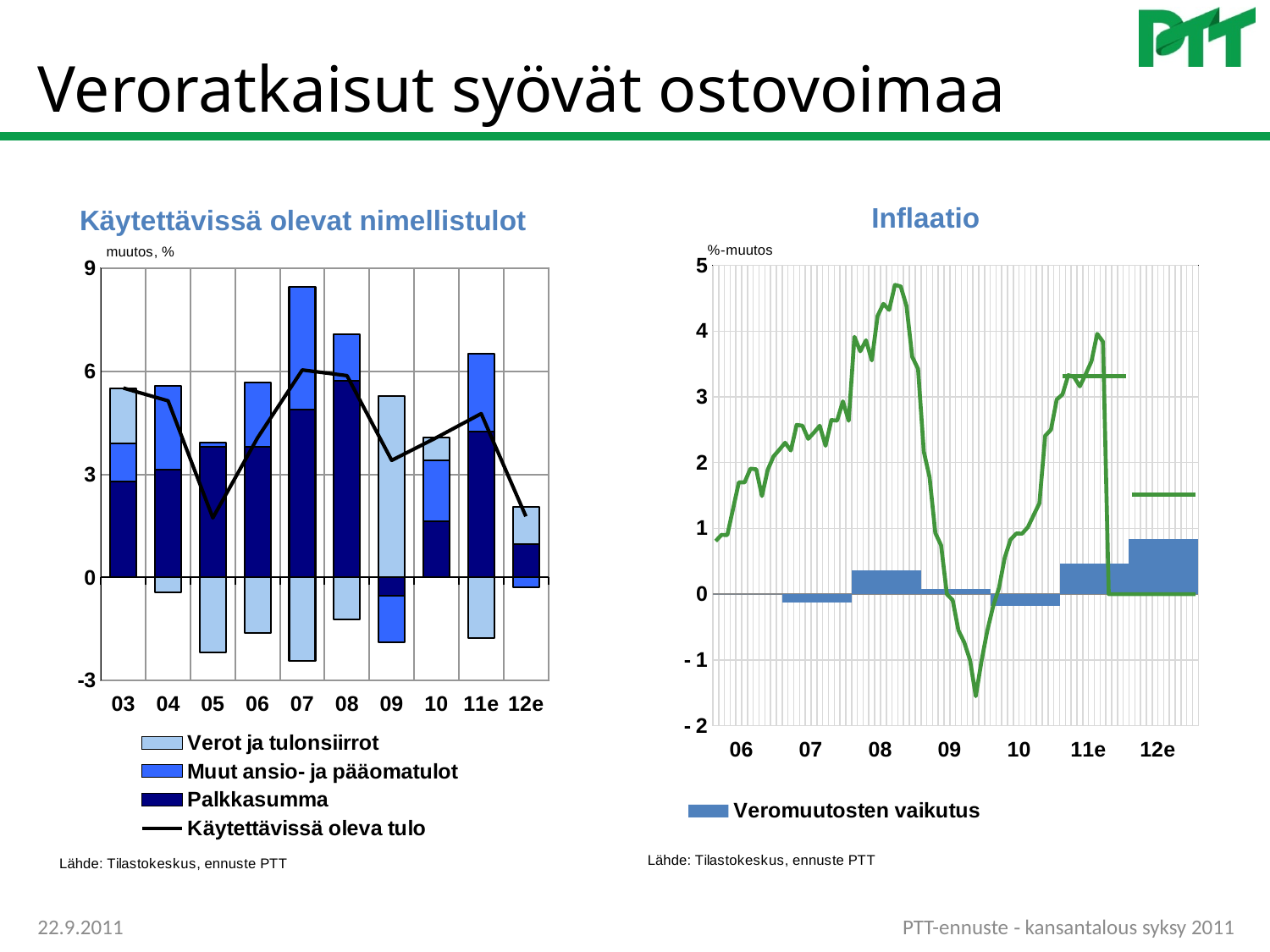
On the left chart 'Käytettävissä olevat nimellistulot', in which year is the Palkkasumma bar lowest? 09 On the left chart 'Käytettävissä olevat nimellistulot', in which year is the Palkkasumma bar highest? 08 On the right chart 'Inflaatio', is the Veromuutosten vaikutus value for 12e greater or less than 1? less On the left chart 'Käytettävissä olevat nimellistulot', how many years are shown on the x axis? 10 What is the y-axis label of the left chart 'Käytettävissä olevat nimellistulot'? muutos, % On the right chart 'Inflaatio', around which year does the inflation line reach its lowest point? 09 On the left chart 'Käytettävissä olevat nimellistulot', is the Verot ja tulonsiirrot value for 09 greater or less than 3? greater On the left chart 'Käytettävissä olevat nimellistulot', how many entries does the legend list? 4 On the left chart 'Käytettävissä olevat nimellistulot', is the Käytettävissä oleva tulo value for 05 greater or less than 3? less What kind of chart is the left chart 'Käytettävissä olevat nimellistulot'? combination bar and line chart (stacked bars with a line) On the left chart 'Käytettävissä olevat nimellistulot', does the Käytettävissä oleva tulo line rise or fall from 05 to 07? rise On the right chart 'Inflaatio', how many entries does the legend list? 1